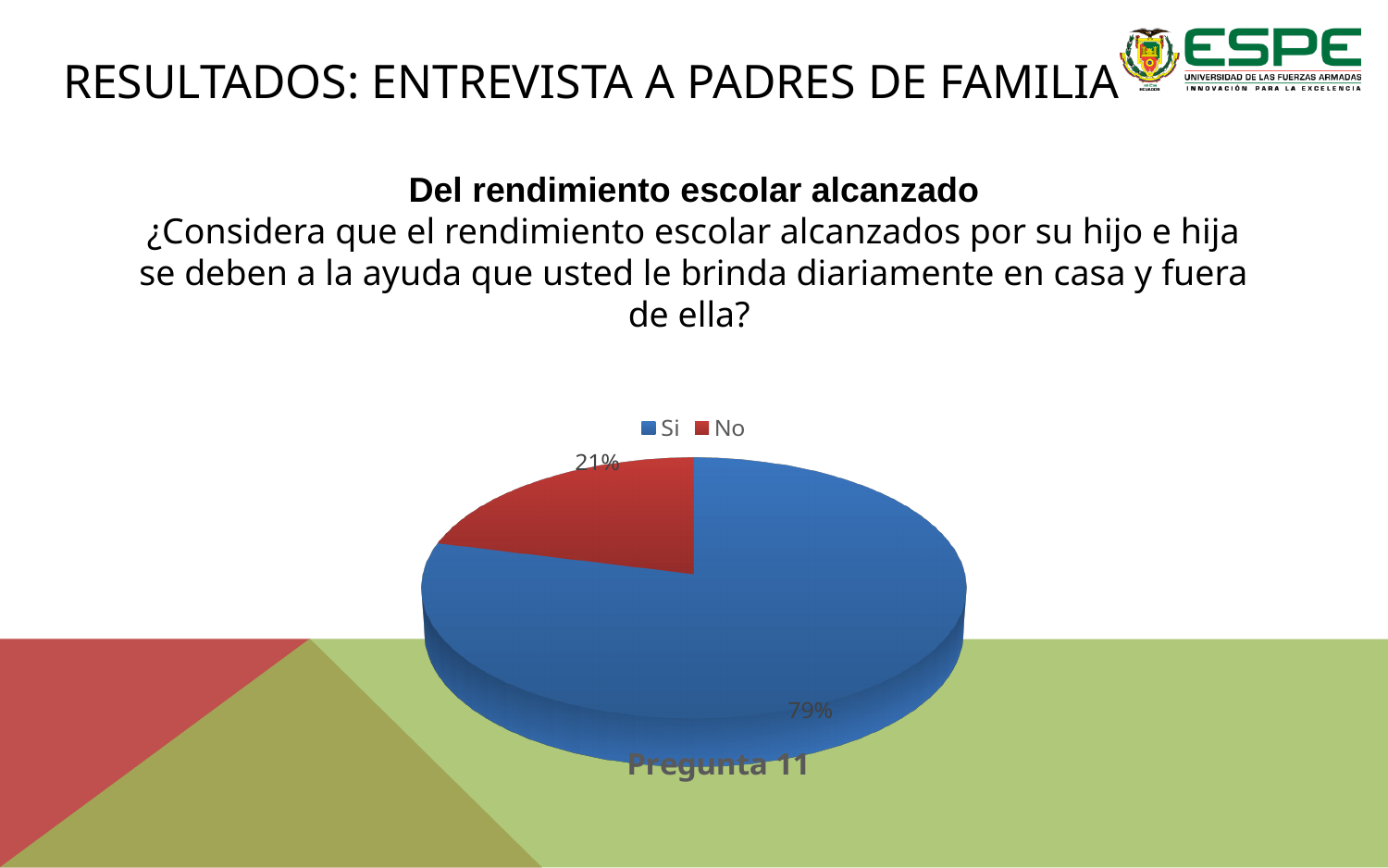
What type of chart is shown on the slide? Pie chart What is the difference in percentage points between the "Si" and "No" slices? 58 What colour is the "Si" slice in the pie chart? Blue What share of the pie does the "No" slice represent? 21% What percentage of parents answered "Si" in the pie chart? 79% How many entries does the chart legend list? 2 How many slices does the pie chart have? 2 Which response has the largest share of the pie chart? Si Which response has the smallest share of the pie chart? No What percentage of parents answered "No" in the pie chart? 21% What is the title shown below the pie chart? Pregunta 11 Which slice is larger, "Si" or "No"? Si